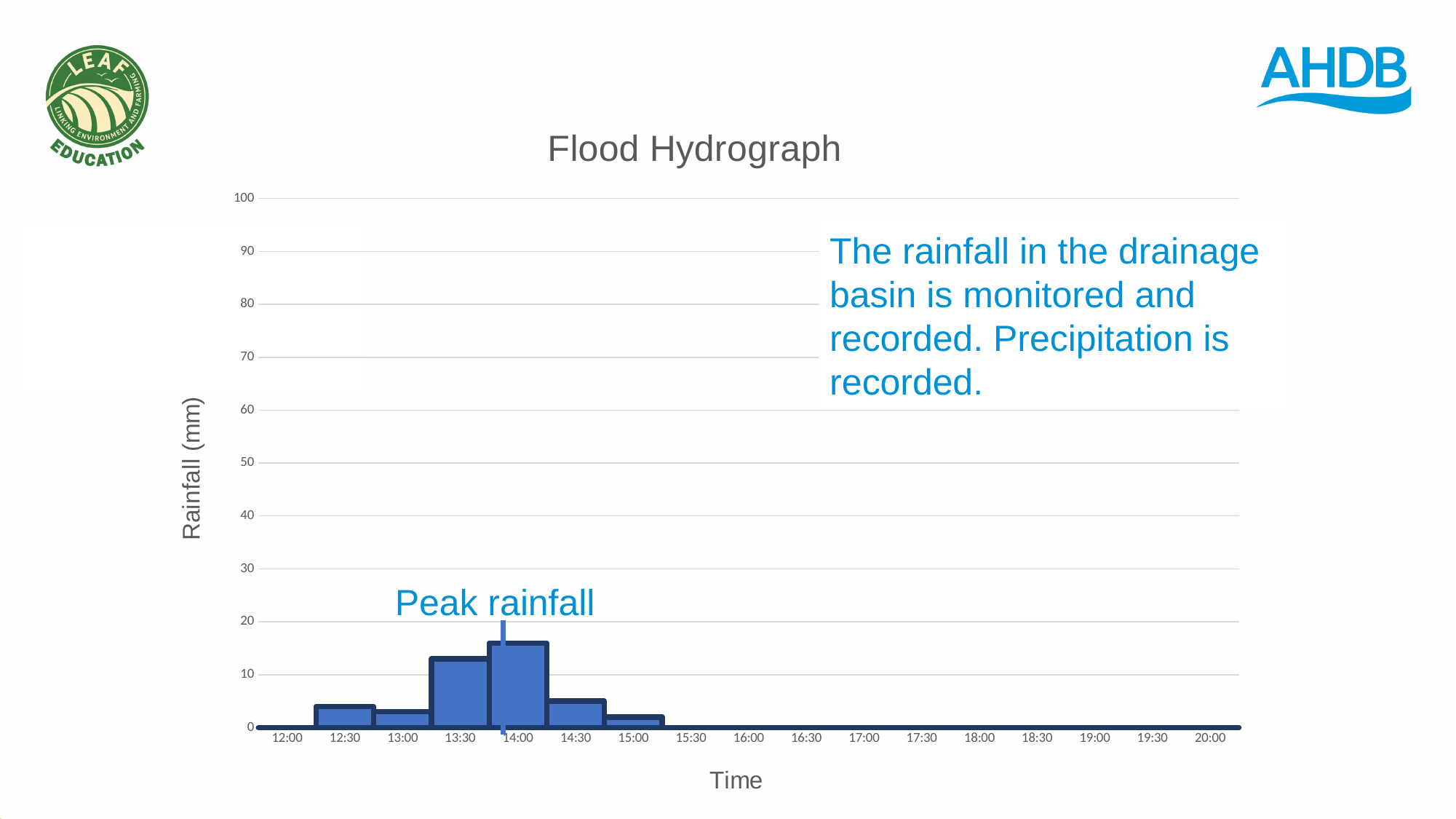
Do the rainfall values rise or fall from 14:00 to 15:00? fall What is the title of the chart? Flood Hydrograph What is the label on the vertical axis of the chart? Rainfall (mm) What kind of chart is shown on the slide? bar chart Is the rainfall value at 12:30 greater or less than 10? less Which has the larger rainfall value, 13:30 or 14:30? 13:30 At which time is the rainfall highest? 14:00 Is the rainfall value at 14:00 greater or less than 10? greater Is the rainfall value at 14:00 greater or less than 20? less Which has the larger rainfall value, 12:30 or 14:00? 14:00 How many time labels are shown along the x axis? 17